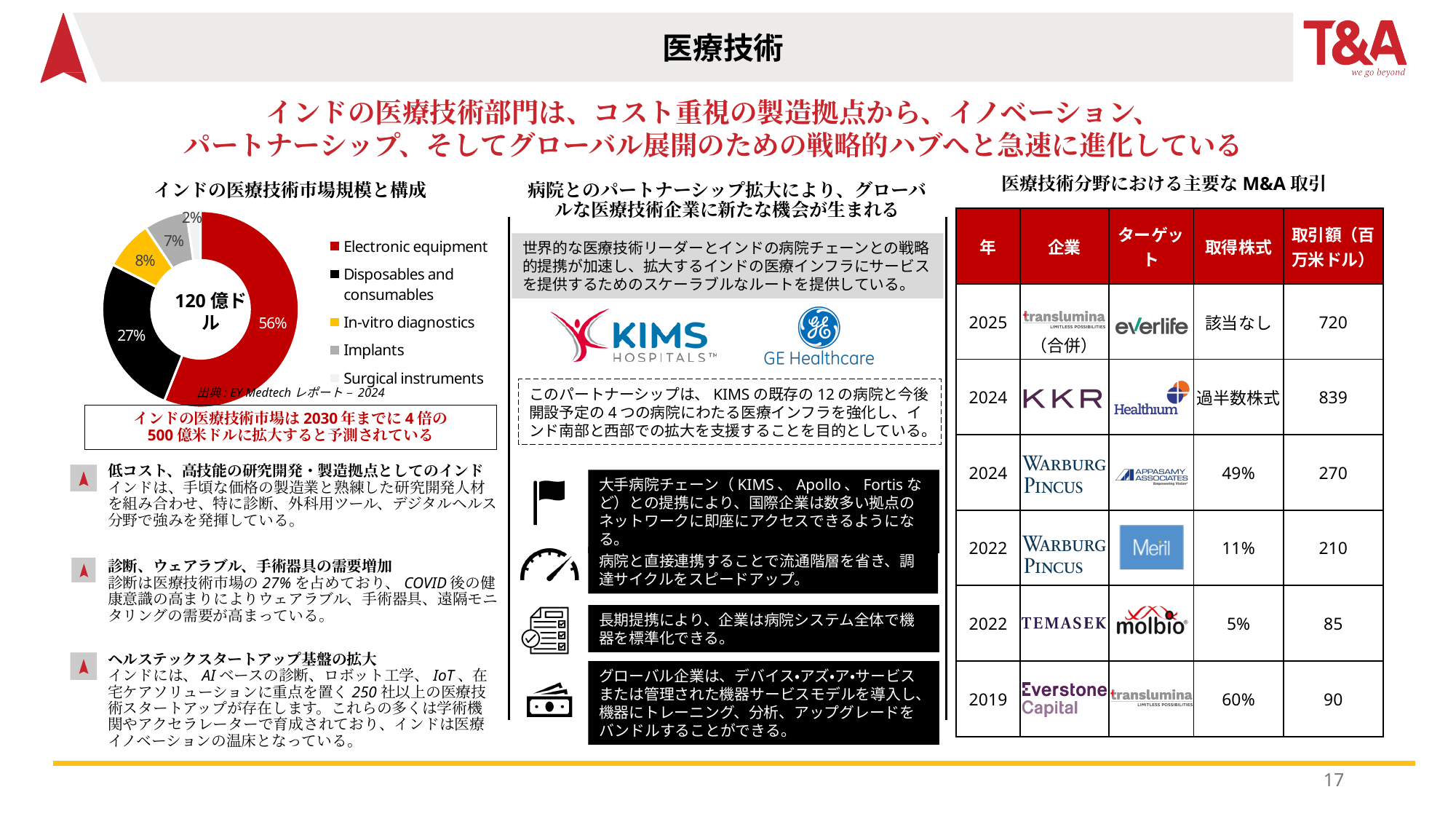
In the donut chart, which is larger: In-vitro diagnostics or Implants? In-vitro diagnostics In the donut chart, what share does Implants hold? 7% Which category has the smallest share in the donut chart? Surgical instruments In the donut chart, what share does In-vitro diagnostics hold? 8% How many categories does the legend of the donut chart list? 5 What type of chart is shown under the title インドの医療技術市場規模と構成? Pie chart (donut) In the donut chart, what share does Electronic equipment hold? 56% In the donut chart, what is the difference in percentage points between Electronic equipment and Disposables and consumables? 29 percentage points What value is printed in the centre of the donut chart? 120 億ドル In the donut chart, what share does Surgical instruments hold? 2% Which category has the largest share in the donut chart? Electronic equipment In the donut chart, what share does Disposables and consumables hold? 27%